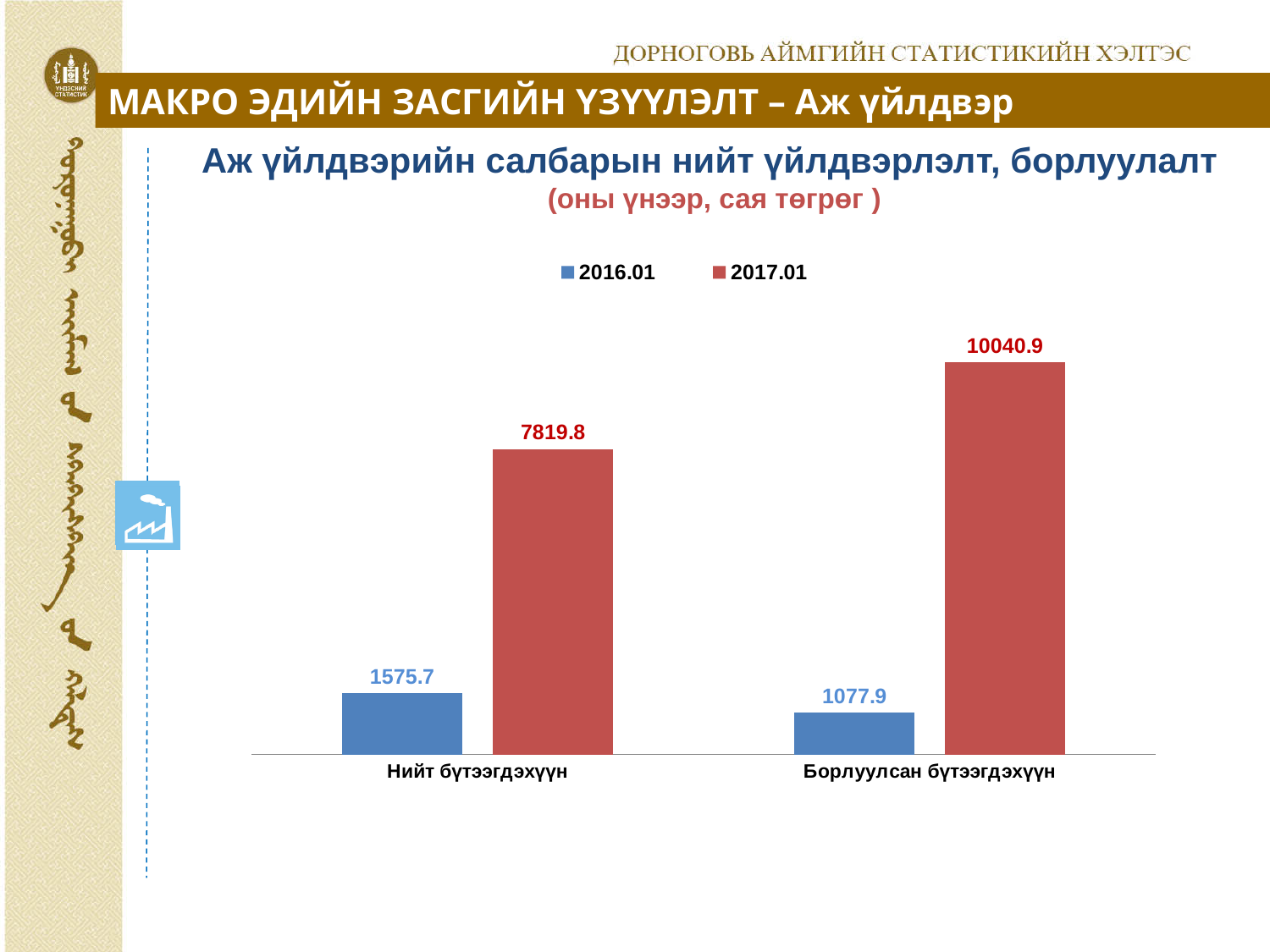
Which bar has the highest value on the chart? 2017.01, Борлуулсан бүтээгдэхүүн What is the difference between the 2017.01 and 2016.01 values for Нийт бүтээгдэхүүн? 6244.1 What is the value for 2017.01 in the Нийт бүтээгдэхүүн category? 7819.8 What is the value for 2016.01 in the Нийт бүтээгдэхүүн category? 1575.7 What is the difference between the 2017.01 values for Борлуулсан бүтээгдэхүүн and Нийт бүтээгдэхүүн? 2221.1 What is the value for 2016.01 in the Борлуулсан бүтээгдэхүүн category? 1077.9 What is the value for 2017.01 in the Борлуулсан бүтээгдэхүүн category? 10040.9 Which bar has the lowest value on the chart? 2016.01, Борлуулсан бүтээгдэхүүн What kind of chart is shown on the slide? Bar chart Which is larger for 2016.01: Нийт бүтээгдэхүүн or Борлуулсан бүтээгдэхүүн? Нийт бүтээгдэхүүн How many categories are shown on the x axis? 2 How many series does the legend list? 2